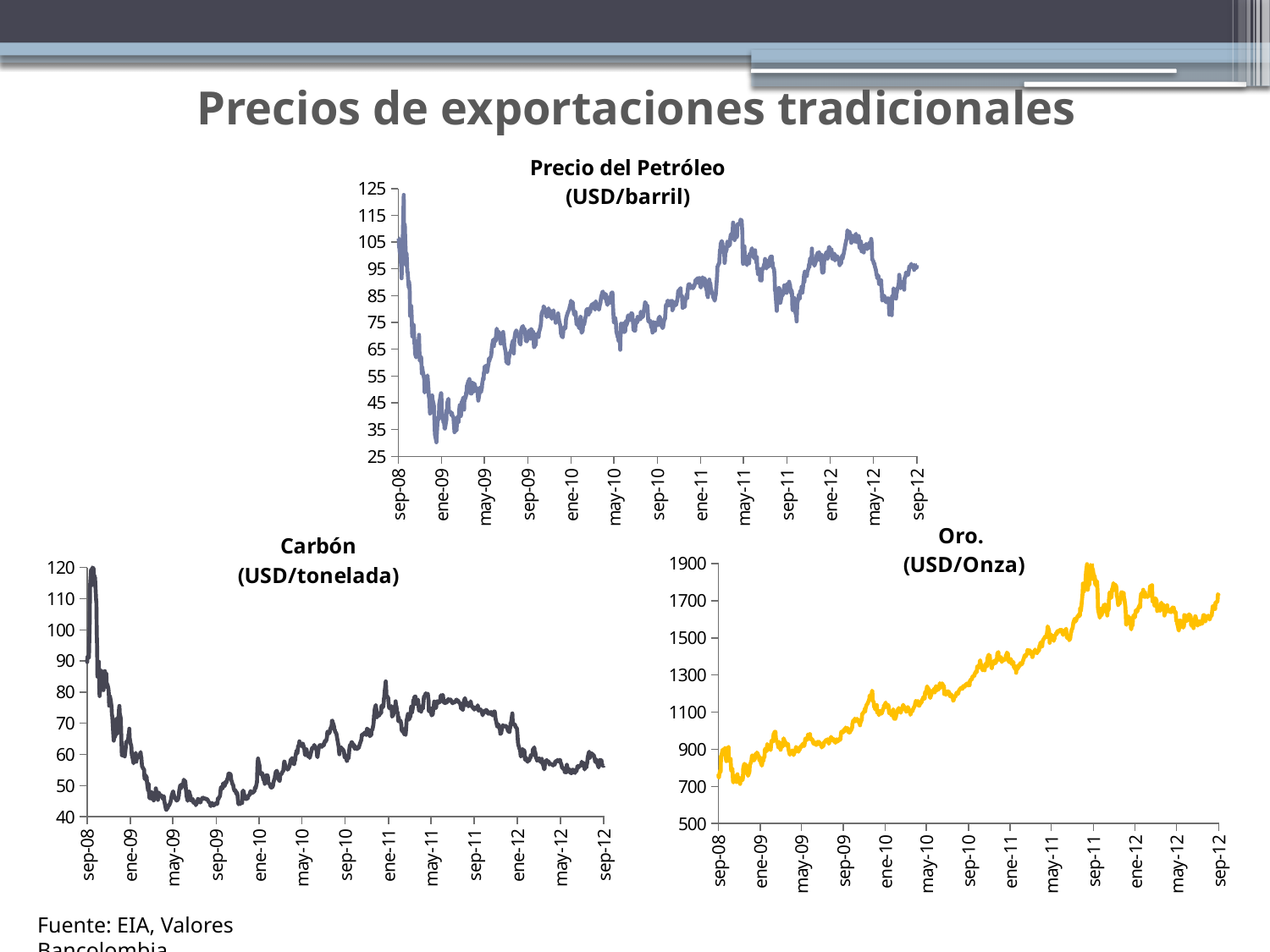
In the 'Oro (USD/Onza)' chart, is the value at sep-08 greater or less than 1100? less In the 'Precio del Petróleo' chart, which is larger: the value at sep-12 or the value at ene-09? sep-12 In the 'Carbón (USD/tonelada)' chart, is the value at may-09 greater or less than 60? less In the 'Precio del Petróleo' chart, is the value at sep-12 greater or less than 85? greater What colour is the line in the 'Oro (USD/Onza)' chart? yellow What unit is shown in the title of the 'Oro' chart? USD/Onza In the 'Oro (USD/Onza)' chart, do values generally rise or fall from sep-08 to sep-12? rise How many charts are shown on the slide? 3 What kind of chart is the 'Precio del Petróleo (USD/barril)' chart? line chart